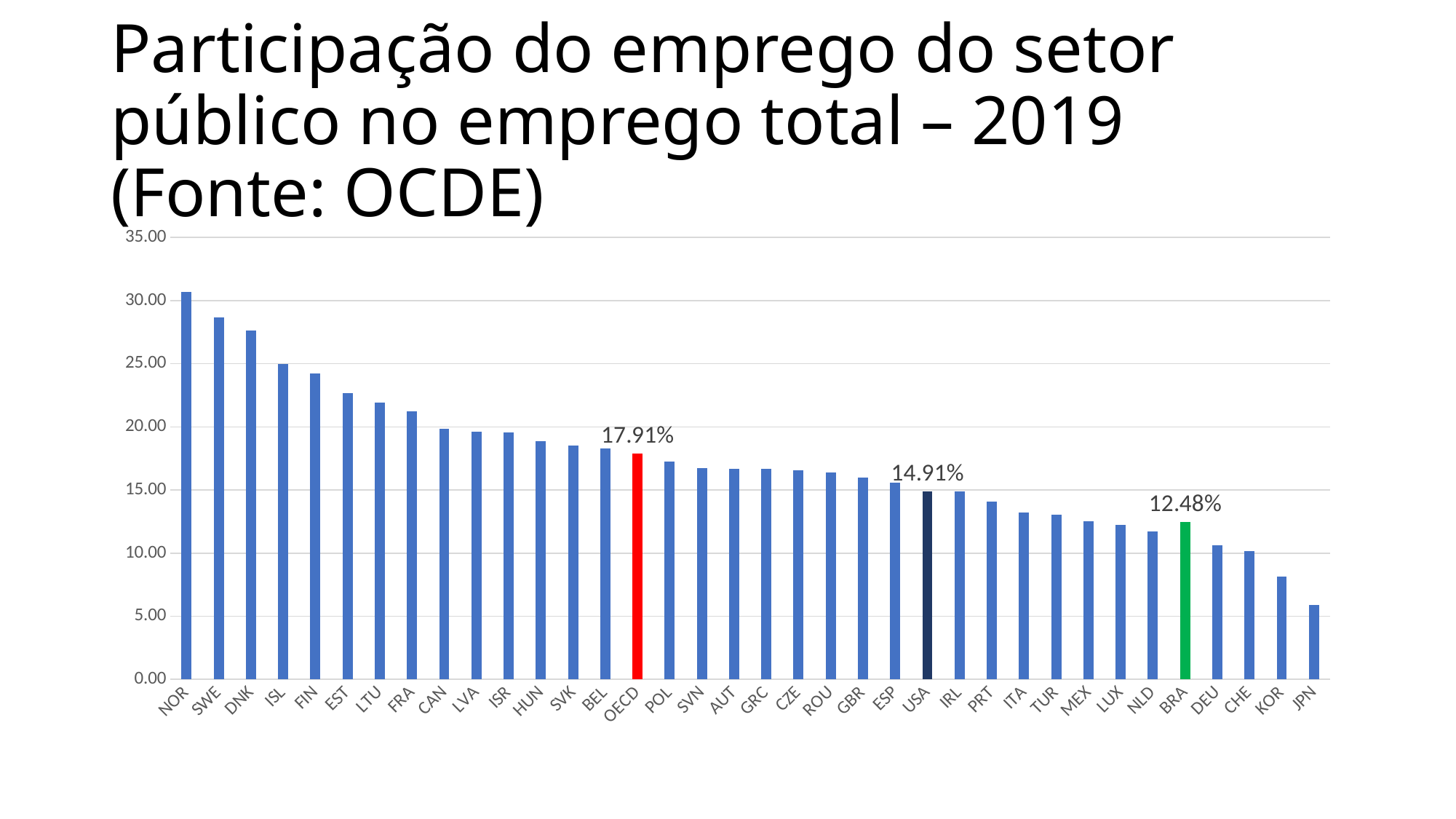
Which country has the highest value? NOR Is the value for KOR greater or less than 10.00? less What is the difference between the labelled values for USA and BRA? 2.43% What value is labelled for BRA? 12.48% Which country has the lowest value? JPN What value is labelled for USA? 14.91% What colour is the OECD bar? Red What is the difference between the labelled values for OECD and USA? 3.00% Is the value for NOR greater or less than 30.00? greater Which is larger, the value for SWE or the value for FIN? SWE What value is labelled for OECD? 17.91% How many categories are shown on the x axis? 36